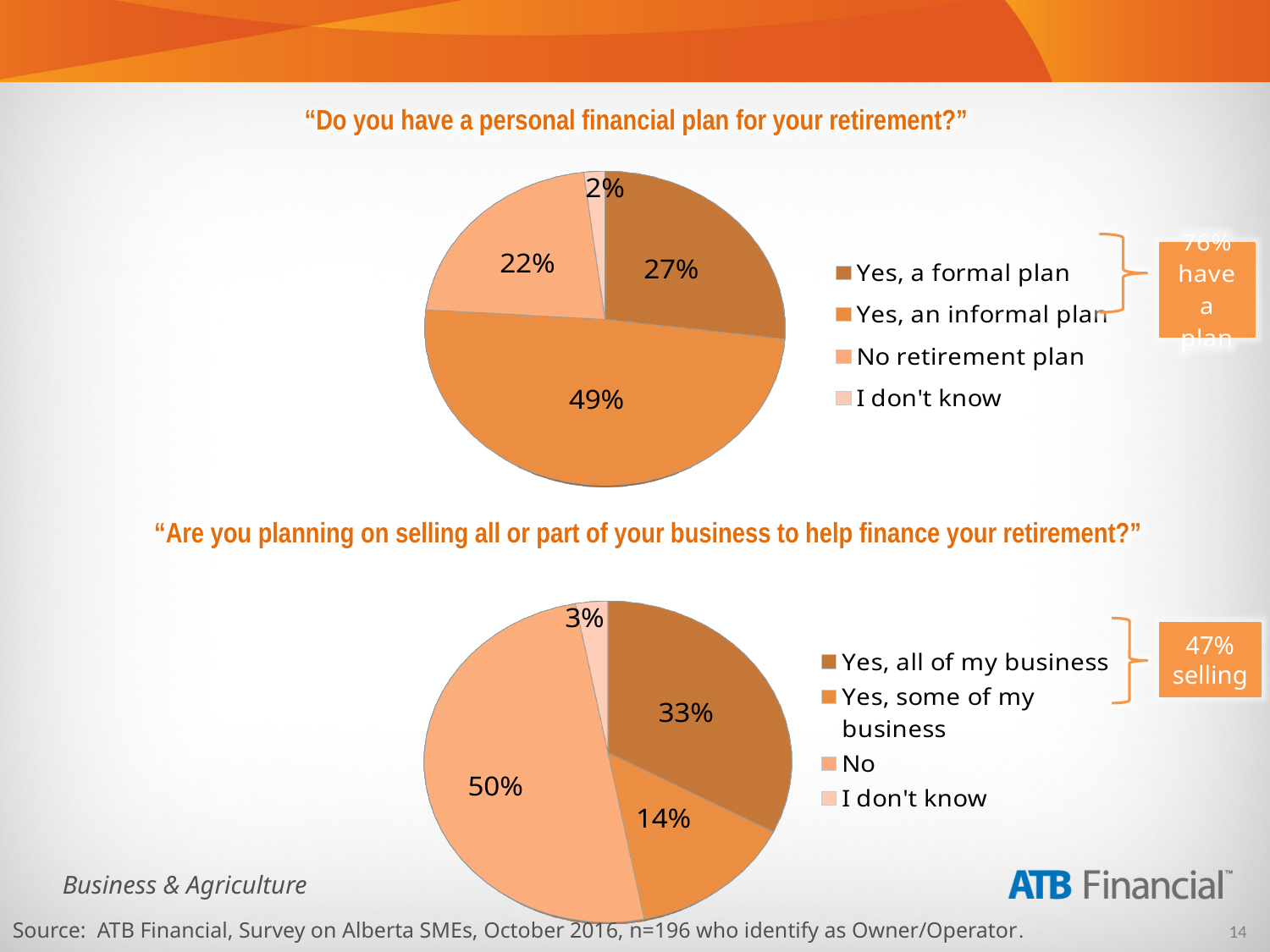
In the bottom pie chart ("Are you planning on selling all or part of your business to help finance your retirement?"), what share of respondents said "Yes, all of my business"? 33% In the top pie chart ("Do you have a personal financial plan for your retirement?"), which response has the smallest share? I don't know In the top pie chart ("Do you have a personal financial plan for your retirement?"), what share of respondents said "No retirement plan"? 22% In the bottom pie chart ("Are you planning on selling all or part of your business to help finance your retirement?"), what is the difference between the shares for "No" and "I don't know"? 47% In the top pie chart ("Do you have a personal financial plan for your retirement?"), what is the difference between the shares for "Yes, a formal plan" and "No retirement plan"? 5% What type of chart is used for both charts on the slide? Pie chart In the bottom pie chart ("Are you planning on selling all or part of your business to help finance your retirement?"), which is larger: the share for "Yes, all of my business" or "Yes, some of my business"? Yes, all of my business In the bottom pie chart ("Are you planning on selling all or part of your business to help finance your retirement?"), which response has the largest share? No In the bottom pie chart ("Are you planning on selling all or part of your business to help finance your retirement?"), what share of respondents said "Yes, some of my business"? 14% In the top pie chart ("Do you have a personal financial plan for your retirement?"), which response has the largest share? Yes, an informal plan In the top pie chart ("Do you have a personal financial plan for your retirement?"), what share of respondents said "Yes, an informal plan"? 49% In the top pie chart ("Do you have a personal financial plan for your retirement?"), how many categories does the legend list? 4